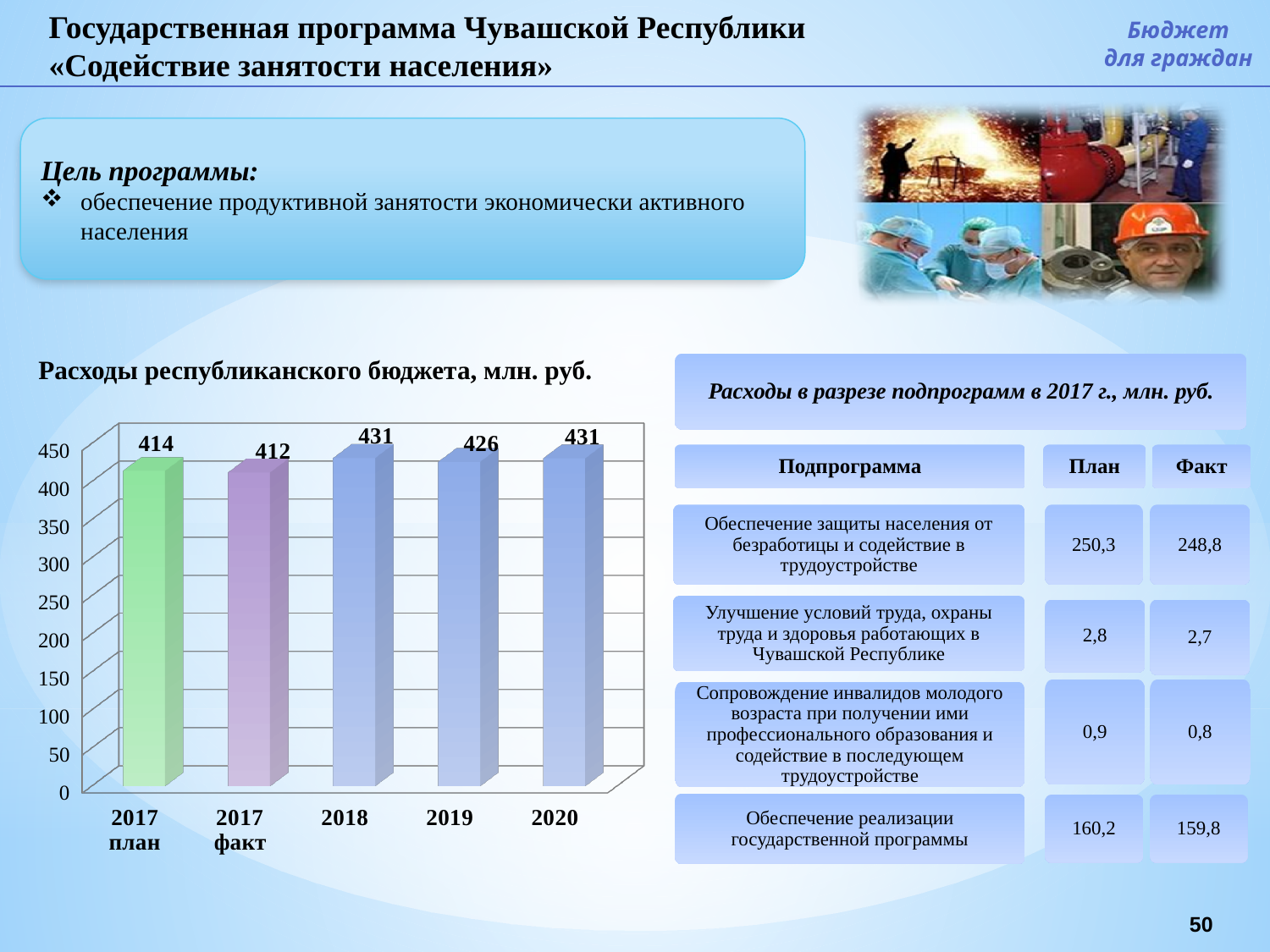
Which category has the lowest value in the chart 'Расходы республиканского бюджета, млн. руб.'? 2017 факт What is the value for 2017 факт in the chart 'Расходы республиканского бюджета, млн. руб.'? 412 What is the highest value shown on the vertical axis of the chart 'Расходы республиканского бюджета, млн. руб.'? 450 What is the value for 2017 план in the chart 'Расходы республиканского бюджета, млн. руб.'? 414 How many bars are shown in the chart 'Расходы республиканского бюджета, млн. руб.'? 5 What is the difference between the 2017 план and 2017 факт values in the chart 'Расходы республиканского бюджета, млн. руб.'? 2 What type of chart is 'Расходы республиканского бюджета, млн. руб.'? bar chart What is the difference between the values for 2018 and 2017 факт in the chart 'Расходы республиканского бюджета, млн. руб.'? 19 What is the value for 2019 in the chart 'Расходы республиканского бюджета, млн. руб.'? 426 Which is larger in the chart 'Расходы республиканского бюджета, млн. руб.': the value for 2018 or the value for 2019? 2018 Is the value for 2020 in the chart 'Расходы республиканского бюджета, млн. руб.' greater or less than 400? greater What colour is the bar for 2017 план in the chart 'Расходы республиканского бюджета, млн. руб.'? green